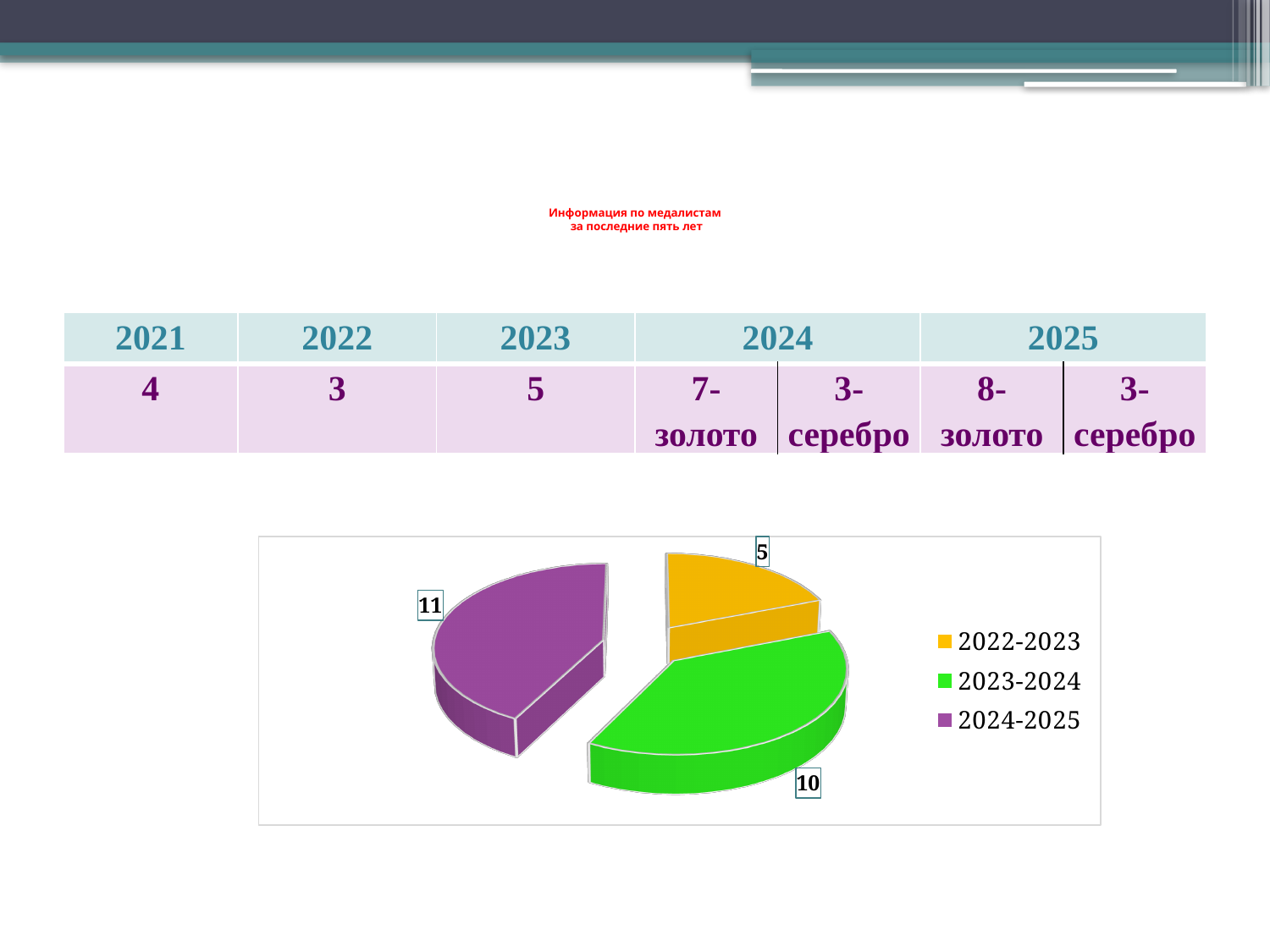
Which is larger in the pie chart, the value for 2023-2024 or the value for 2022-2023? 2023-2024 What is the value for 2024-2025 in the pie chart? 11 What type of chart is shown on the slide? pie chart How many slices does the pie chart have? 3 What is the total of all the values shown in the pie chart? 26 What is the value for 2023-2024 in the pie chart? 10 What is the difference between the values for 2024-2025 and 2022-2023 in the pie chart? 6 What colour is the 2024-2025 slice in the pie chart? purple Which category has the largest slice in the pie chart? 2024-2025 What is the value for 2022-2023 in the pie chart? 5 Which category has the smallest slice in the pie chart? 2022-2023 What is the difference between the values for 2023-2024 and 2022-2023 in the pie chart? 5